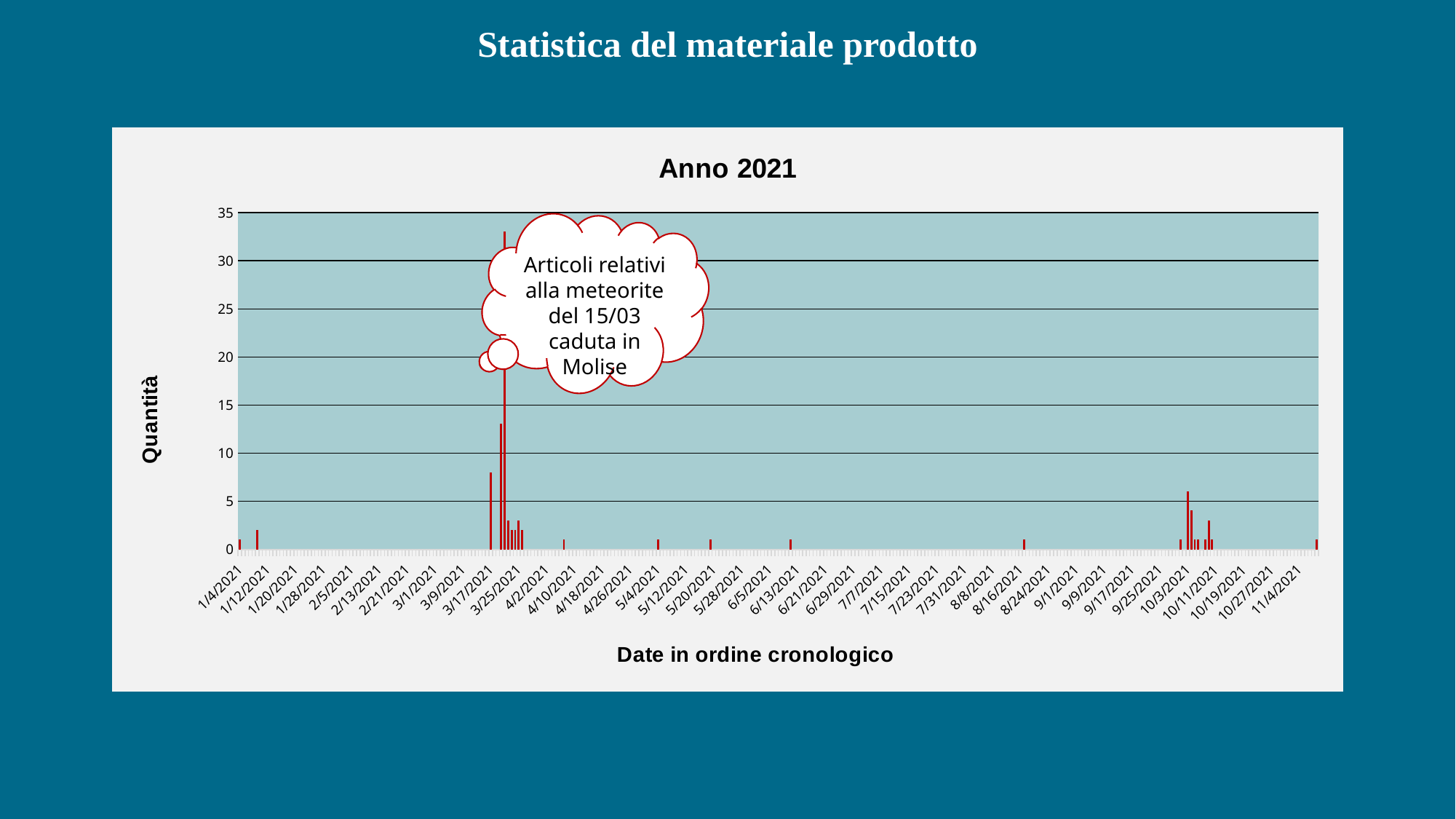
Is the value of the tallest bar in October 2021 greater or less than 10? less Is the value of the tallest bar on the chart greater or less than 30? greater In which month of 2021 does the tallest bar on the chart occur? March What is the title of the chart? Anno 2021 What does the callout on the chart say the spike in March refers to? Articoli relativi alla meteorite del 15/03 caduta in Molise What is the highest value shown on the vertical axis of the chart? 35 Is the value of the bar near 1/12/2021 greater or less than 5? less What kind of chart is shown on the slide? bar chart Which is higher: the peak of bars in March 2021 or the peak of bars in October 2021? March 2021